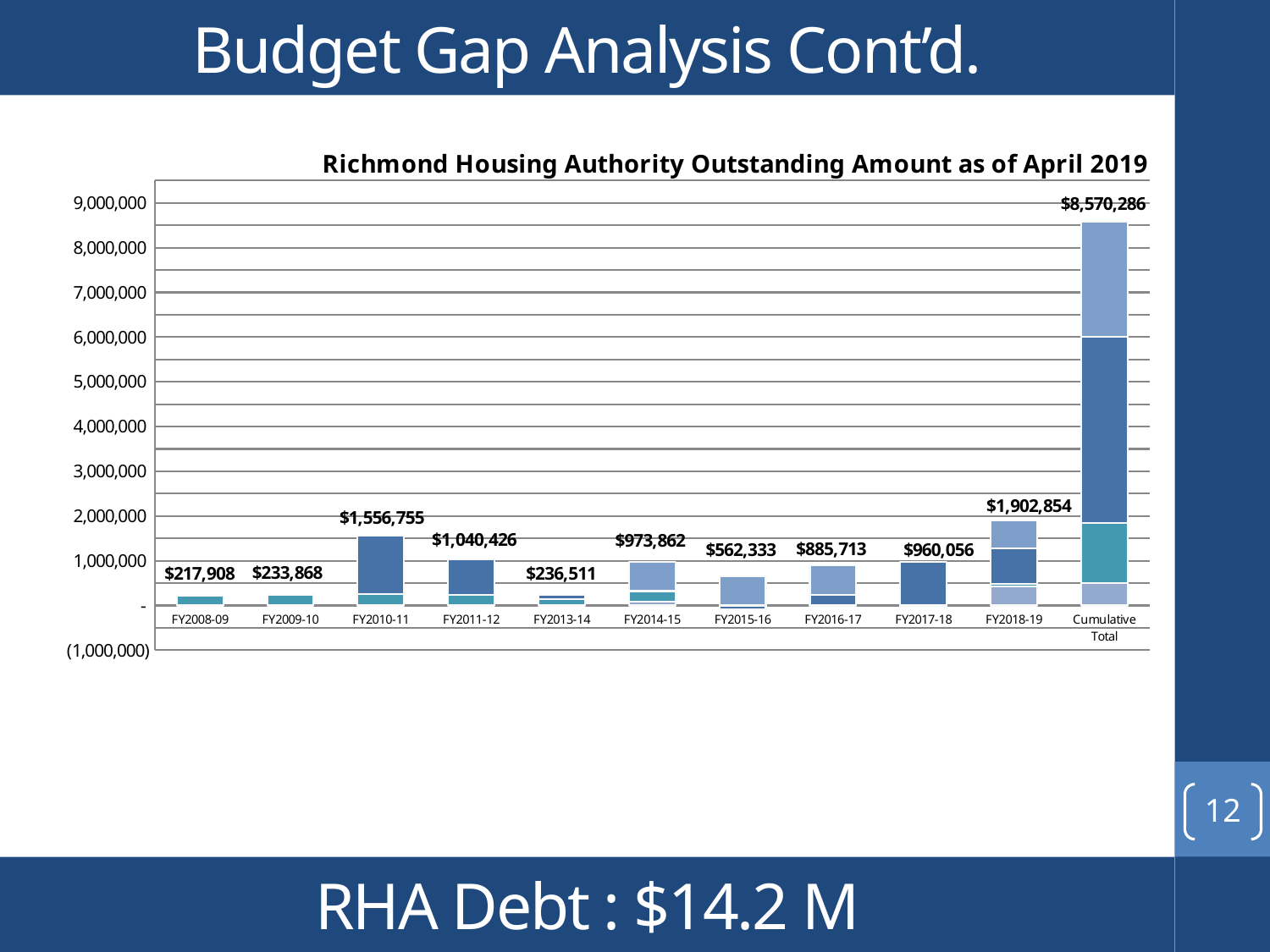
Which fiscal year has the lowest labeled total? FY2008-09 What is the title of the chart? Richmond Housing Authority Outstanding Amount as of April 2019 What kind of chart is shown on the slide? Stacked bar chart Which category has the highest labeled total? Cumulative Total What is the total labeled for FY2015-16? $562,333 What is the difference between the labeled totals for FY2018-19 and FY2017-18? $942,798 Which is larger, the labeled total for FY2011-12 or for FY2014-15? FY2011-12 What is the value labeled for the Cumulative Total bar? $8,570,286 How many categories are shown on the x axis? 11 What is the total labeled for FY2018-19? $1,902,854 Is the total for FY2016-17 greater or less than 1,000,000? less What is the total labeled for FY2010-11? $1,556,755